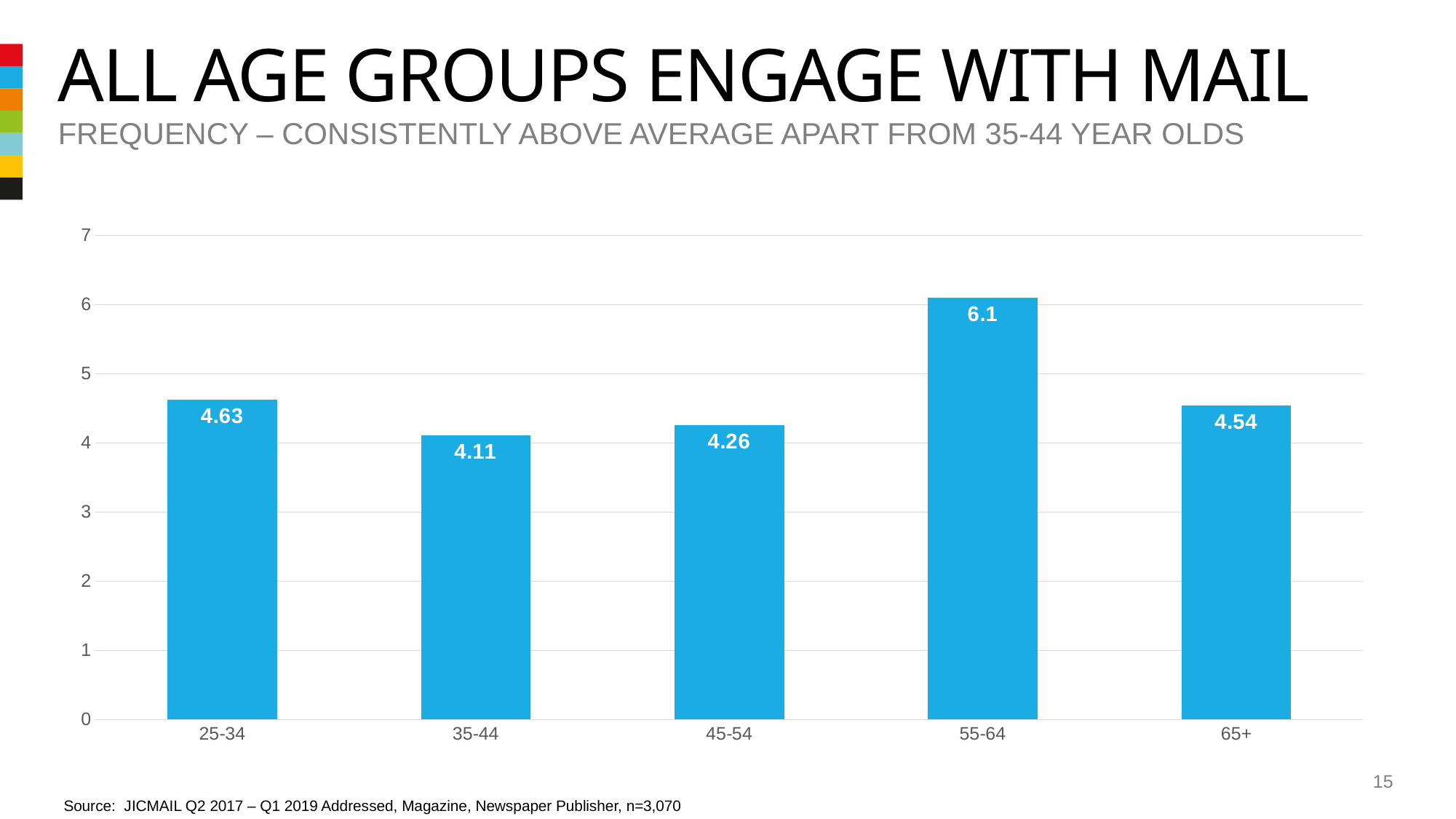
What is the value for the 65+ age group? 4.54 What is the value for the 55-64 age group? 6.1 Which age group has the highest value? 55-64 What is the subtitle of the slide? FREQUENCY – CONSISTENTLY ABOVE AVERAGE APART FROM 35-44 YEAR OLDS How many age groups are shown on the chart? 5 What is the difference between the values for 55-64 and 35-44? 1.99 Is the value for 45-54 greater or less than 5? less What is the value for the 25-34 age group? 4.63 Which is larger, the value for 25-34 or the value for 65+? 25-34 Which age group has the lowest value? 35-44 What kind of chart is shown on the slide? bar chart What is the value for the 35-44 age group? 4.11